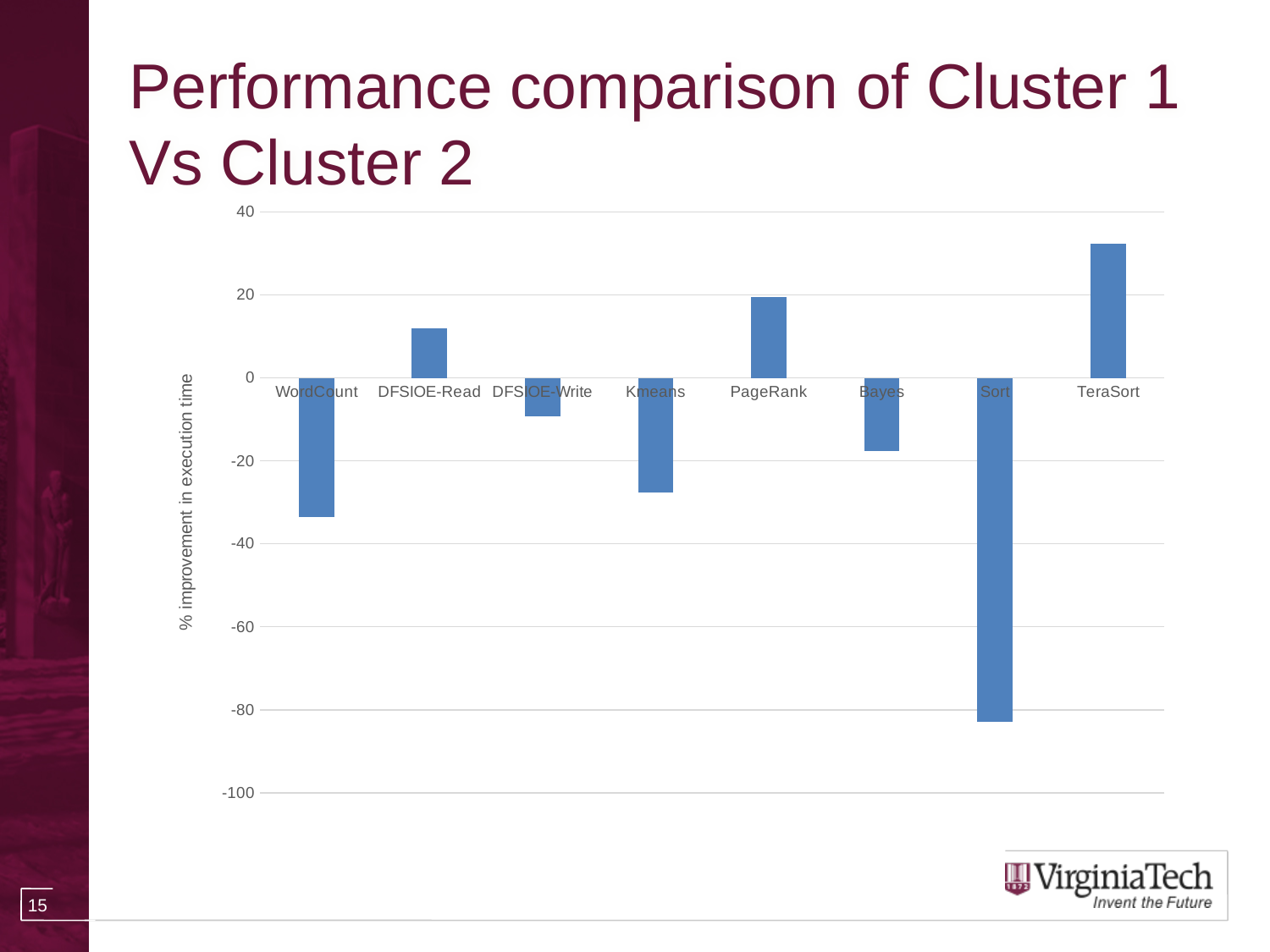
Which is larger, the value for PageRank or the value for DFSIOE-Read? PageRank Which category has the lowest value? Sort Is the value for DFSIOE-Read greater or less than 0? greater What kind of chart is shown on the slide? bar chart Is the value for WordCount greater or less than -20? less Which category has the highest value? TeraSort Is the value for Bayes greater or less than -20? greater Which is larger, the value for Kmeans or the value for DFSIOE-Write? DFSIOE-Write What is the label on the vertical axis of the chart? % improvement in execution time How many categories are plotted on the x axis? 8